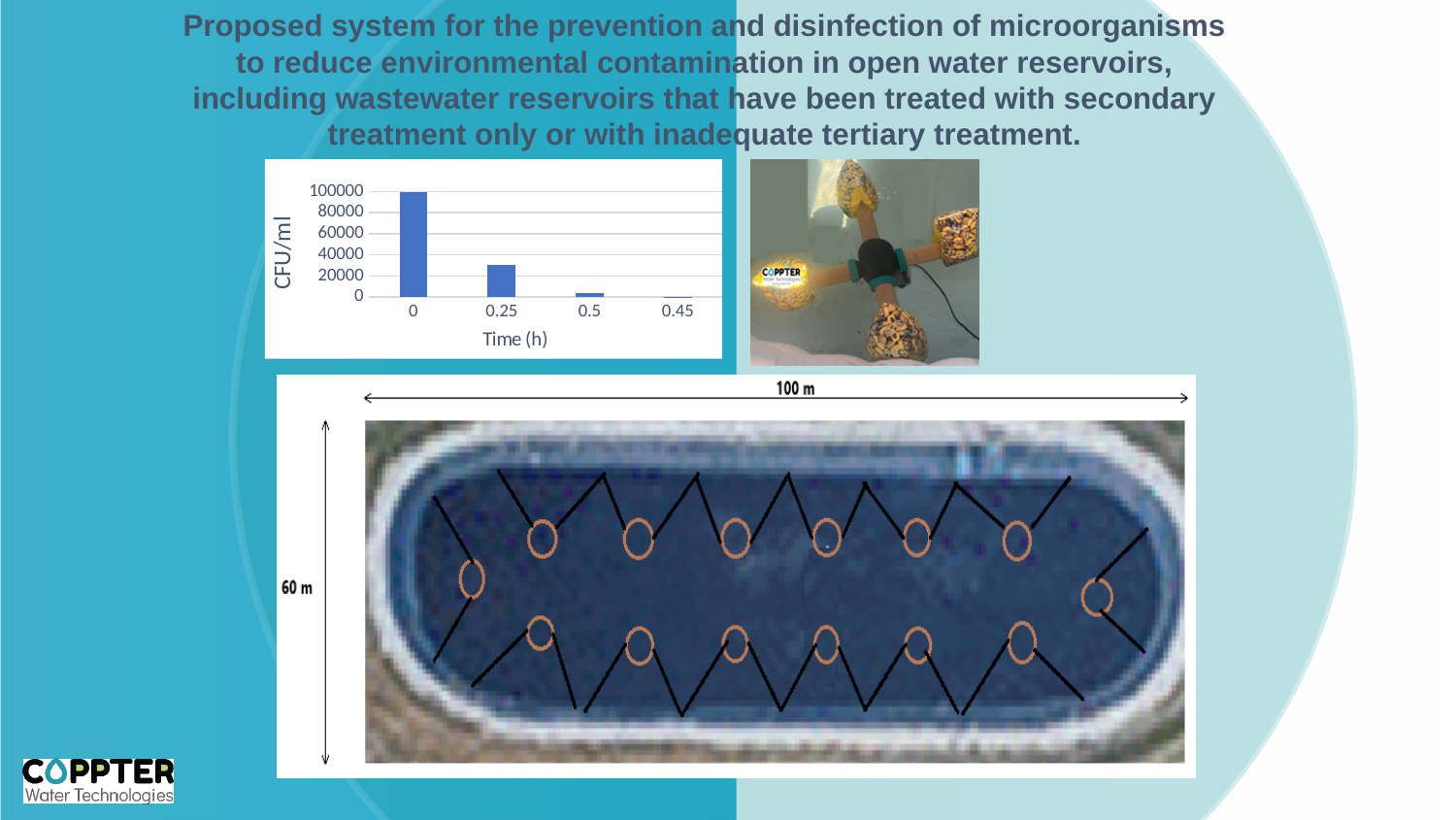
What kind of chart is shown on the slide? bar chart Is the CFU/ml value at time 0.25 greater or less than 40000? less How many time categories are plotted on the x axis of the chart? 4 What is the CFU/ml value at time 0? 100000 Is the CFU/ml value at time 0.25 greater or less than 20000? greater What is the label of the x axis of the chart? Time (h) What is the label of the y axis of the chart? CFU/ml Which has the larger CFU/ml value, time 0.25 or time 0.5? 0.25 Which time category has the highest CFU/ml value? 0 Which has the larger CFU/ml value, time 0 or time 0.25? 0 Do the CFU/ml values generally rise or fall from left to right along the x axis? fall Is the CFU/ml value at time 0.5 greater or less than 20000? less